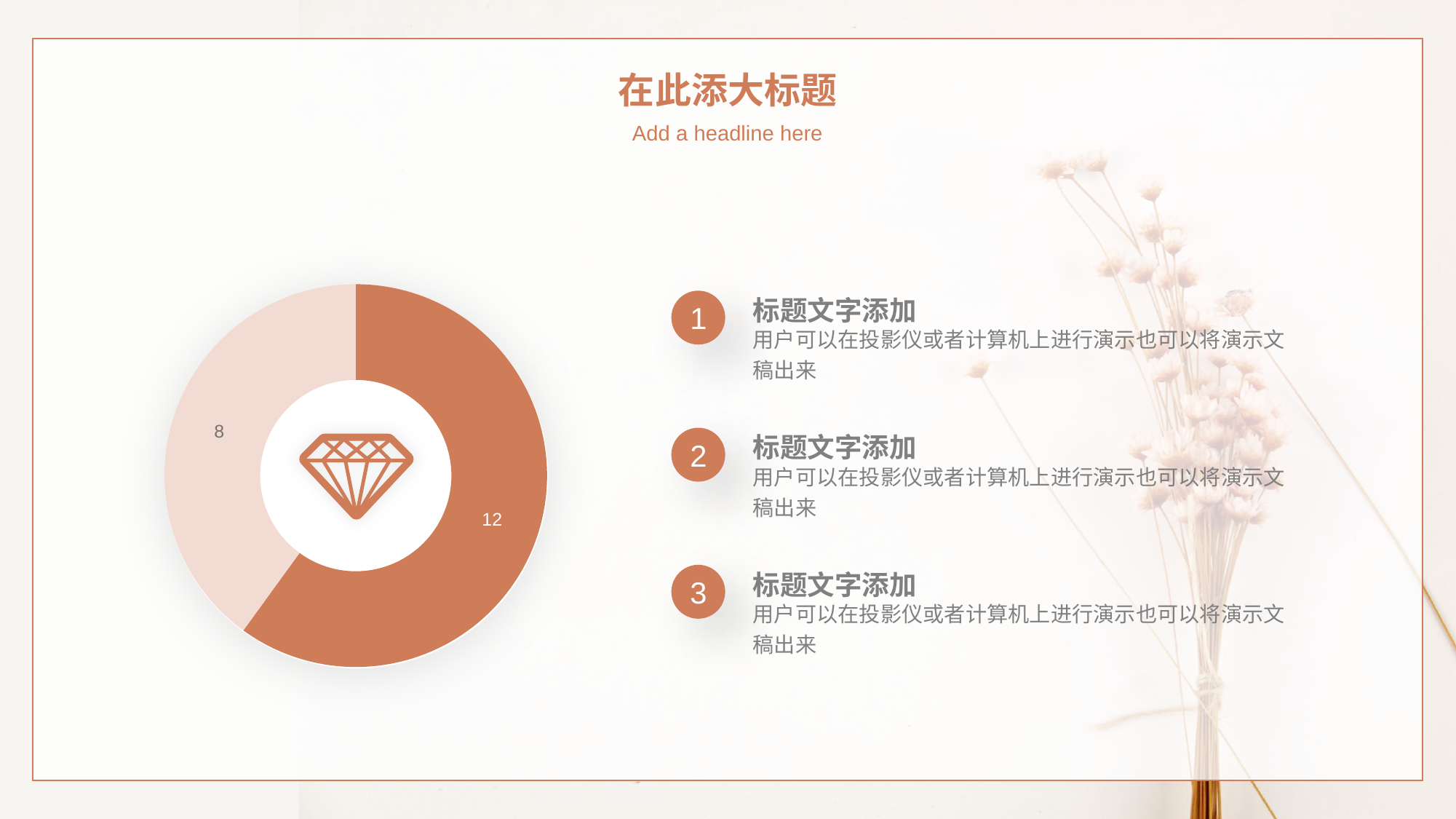
What is the difference between the two slice values in the pie chart? 4 Which is larger in the pie chart, the dark orange slice or the light pink slice? the dark orange slice What share of the pie chart does the slice labelled 12 represent? 60% What value is labelled on the light pink slice of the pie chart? 8 What icon is shown in the centre of the pie chart? a diamond Which slice of the pie chart is the smallest? the light pink slice (8) How many slices does the pie chart have? 2 What kind of chart is shown on the slide? doughnut chart What value is labelled on the dark orange slice of the pie chart? 12 What is the total of the two slice values in the pie chart? 20 Which slice of the pie chart is the largest? the dark orange slice (12) What share of the pie chart does the slice labelled 8 represent? 40%